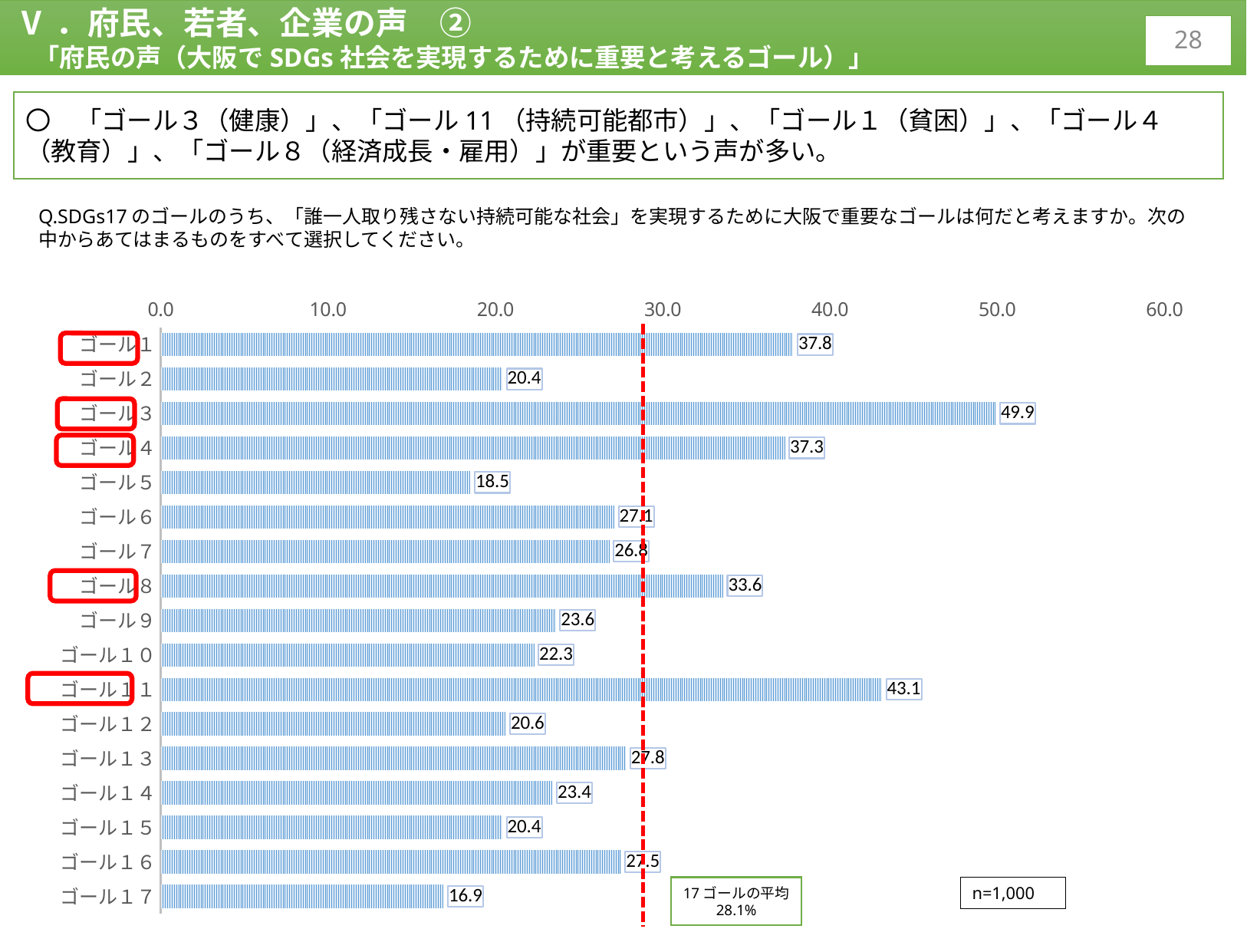
Which goal has the lowest value? ゴール17 Is the value for ゴール8 greater or less than 30.0? greater What is the value for ゴール11? 43.1 What kind of chart is shown on the slide? bar chart What is the value for ゴール17? 16.9 What is the value for ゴール3? 49.9 What is the average of the 17 goals shown in the box on the chart? 28.1% Which has a larger value, ゴール1 or ゴール8? ゴール1 What is the difference between the values for ゴール3 and ゴール11? 6.8 What is the sample size (n) shown on the chart? n=1,000 Which goal has the highest value? ゴール3 How many goals (categories) are plotted in the chart? 17